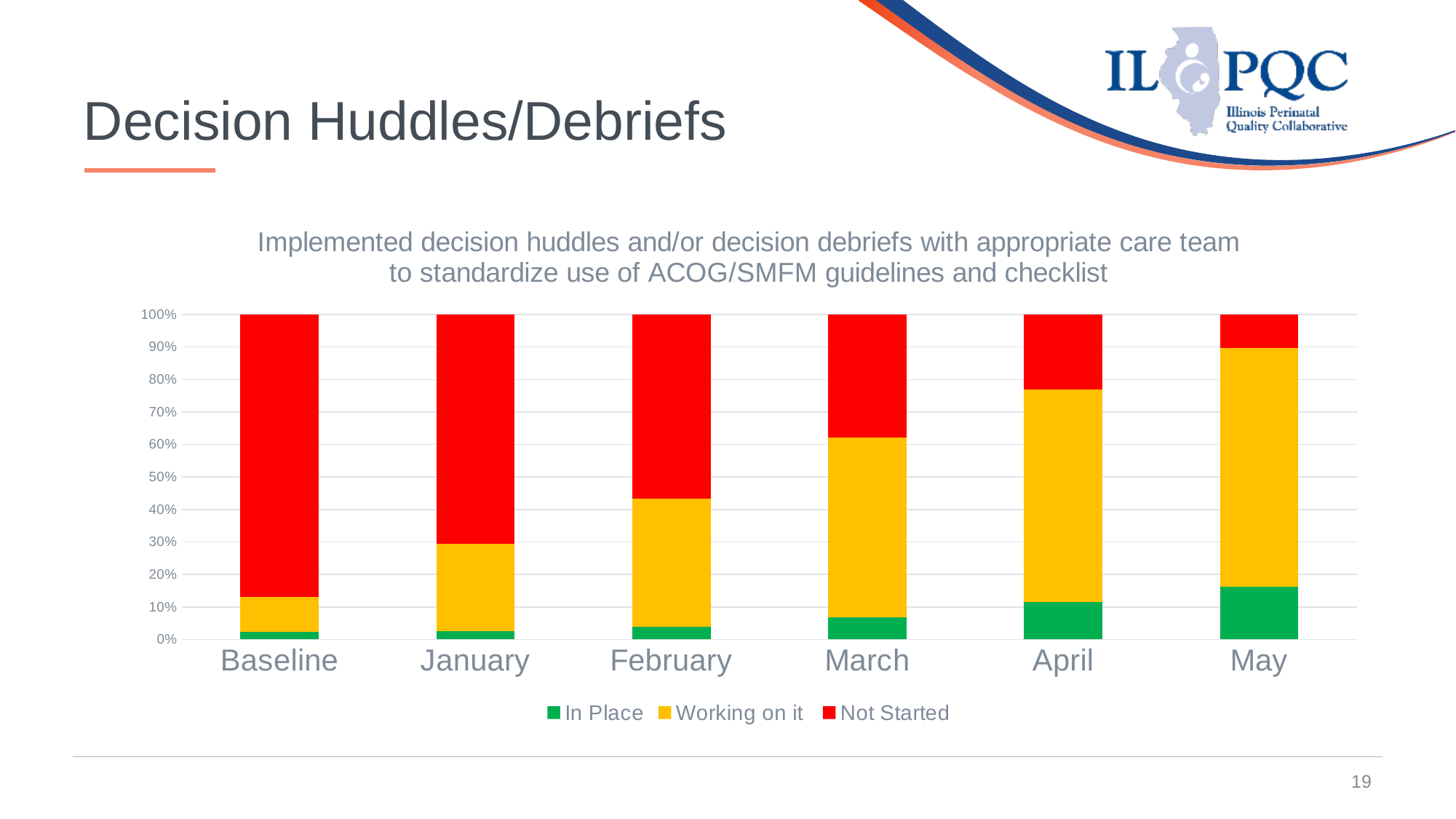
What kind of chart is shown on the slide? Stacked bar chart How many categories are shown along the x axis of the chart? 6 Which category has the smallest 'Not Started' segment? May Is the 'Not Started' segment larger for January or for April? January Which colour represents 'Not Started' in the chart? Red Which category has the largest 'Not Started' segment? Baseline Is the 'In Place' value for May greater or less than 10%? greater Is the 'Not Started' value for May greater or less than 20%? less Which category has the largest 'In Place' segment? May Is the 'Not Started' value for Baseline greater or less than 80%? greater Does the 'In Place' share rise or fall from Baseline to May? Rise How many series does the chart's legend list? 3